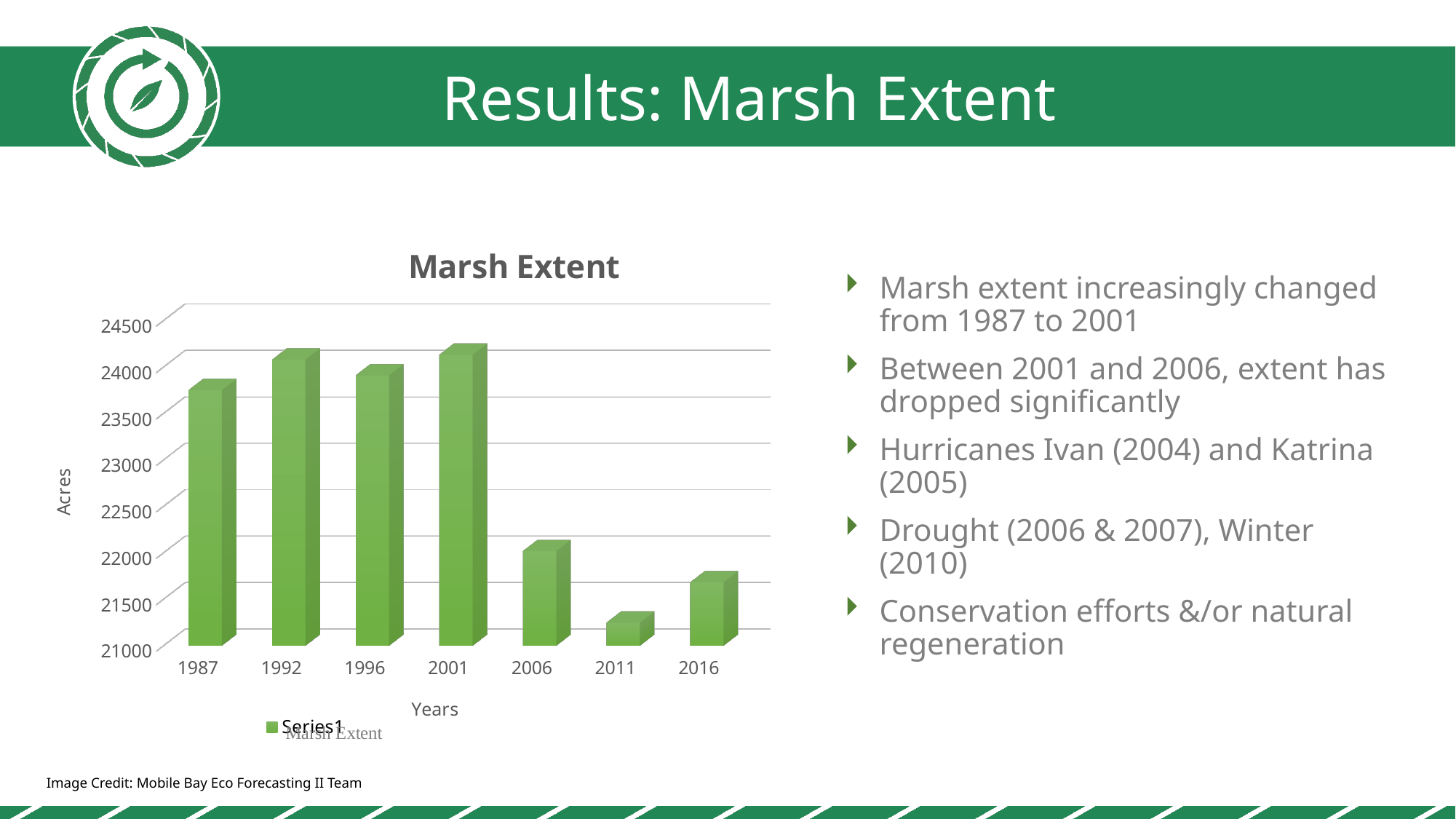
How many series does the legend of the Marsh Extent chart list? 1 How many years are plotted on the x axis of the Marsh Extent chart? 7 Which year has the lowest marsh extent in the chart? 2011 What kind of chart is shown on the slide? bar chart What is the label on the vertical axis of the chart? Acres Do the marsh extent values rise or fall from 2001 to 2011? fall Which year has the larger marsh extent, 2011 or 2016? 2016 Is the marsh extent for 2016 greater or less than 22000 acres? less Is the marsh extent for 1987 greater or less than 23500 acres? greater Is the marsh extent for 2011 greater or less than 21500 acres? less Which year has the larger marsh extent, 1987 or 2006? 1987